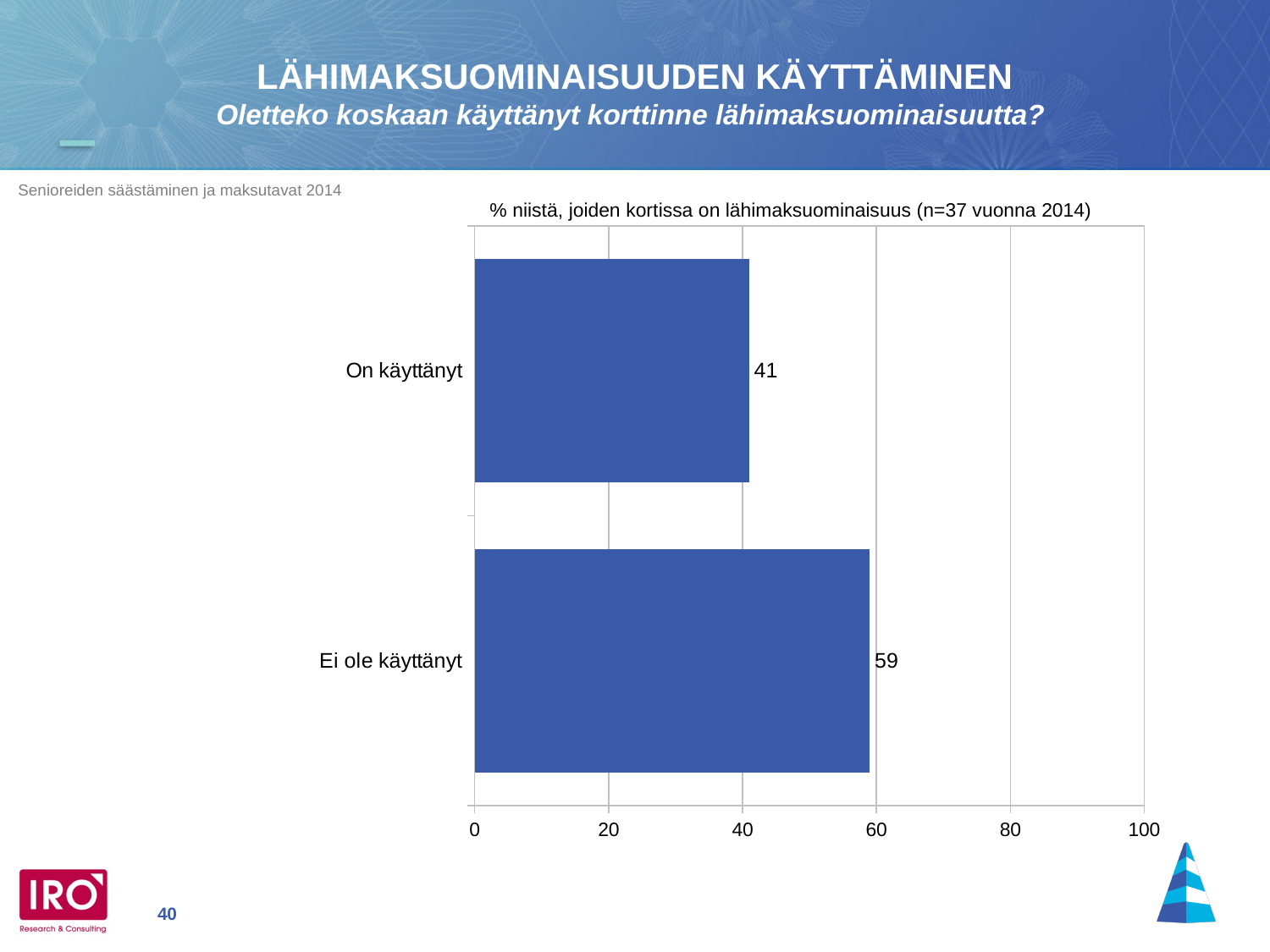
Which is larger, the value for "On käyttänyt" or the value for "Ei ole käyttänyt"? Ei ole käyttänyt What kind of chart is shown on the slide? bar chart How many categories are shown in the chart? 2 Is the value for "On käyttänyt" greater or less than 60? less Which category has the lowest value? On käyttänyt Which category has the highest value? Ei ole käyttänyt What is the value for "Ei ole käyttänyt"? 59 What is the total of the two values shown in the chart? 100 Is the value for "Ei ole käyttänyt" greater or less than 40? greater What is the difference between the values for "Ei ole käyttänyt" and "On käyttänyt"? 18 What is the value for "On käyttänyt"? 41 What is the maximum value shown on the horizontal axis of the chart? 100